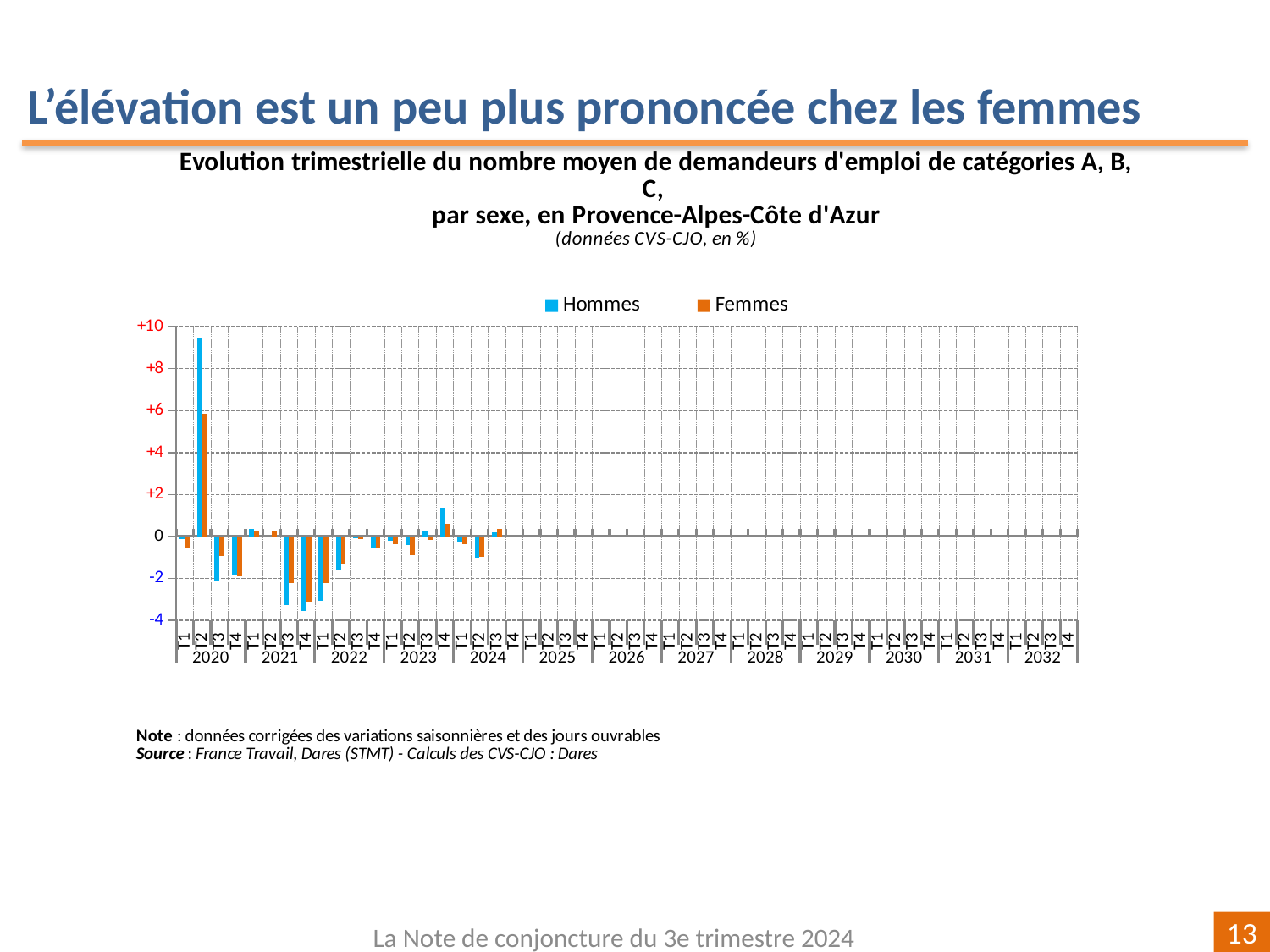
What kind of chart is shown on the slide? bar chart Is the Hommes value for T4 2023 greater or less than +2? less In which quarter does the Hommes series reach its lowest value? T4 2021 Is the Hommes value for T4 2021 greater or less than -2? less How many series does the legend list? 2 In which quarter does the Femmes series reach its highest value? T2 2020 In T2 2020, which series has the larger value, Hommes or Femmes? Hommes In which quarter does the Hommes series reach its highest value? T2 2020 Which colour represents the Femmes series? orange Is the Hommes value for T2 2020 greater or less than +8? greater What are the two series named in the legend? Hommes and Femmes